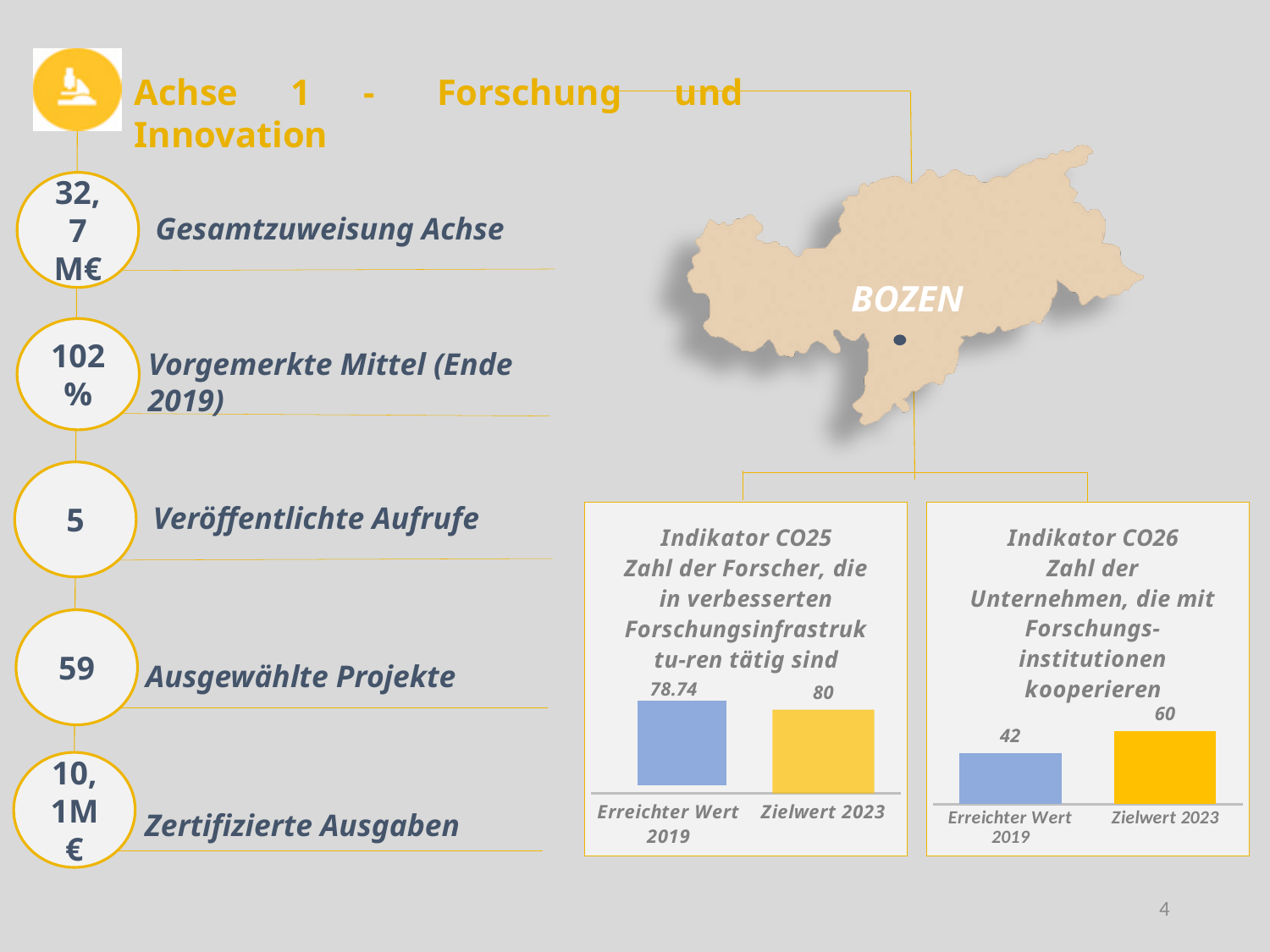
In the Indikator CO26 chart, what is the difference between Zielwert 2023 and Erreichter Wert 2019? 18 In the Indikator CO26 chart, which category has the lower value? Erreichter Wert 2019 In the Indikator CO26 chart, which category has the higher value? Zielwert 2023 How many bars are shown in the Indikator CO25 chart? 2 In the Indikator CO26 chart, what is the value for Erreichter Wert 2019? 42 In the Indikator CO25 chart, what is the difference between Zielwert 2023 and Erreichter Wert 2019? 1.26 In the Indikator CO25 chart, what is the value for Erreichter Wert 2019? 78.74 In the Indikator CO26 chart, what is the value for Zielwert 2023? 60 In the Indikator CO26 chart, is the value for Erreichter Wert 2019 larger or smaller than the value for Zielwert 2023? smaller In the Indikator CO26 chart, what colour is the Zielwert 2023 bar? yellow What type of chart is the Indikator CO26 chart? bar chart In the Indikator CO25 chart, what is the value for Zielwert 2023? 80